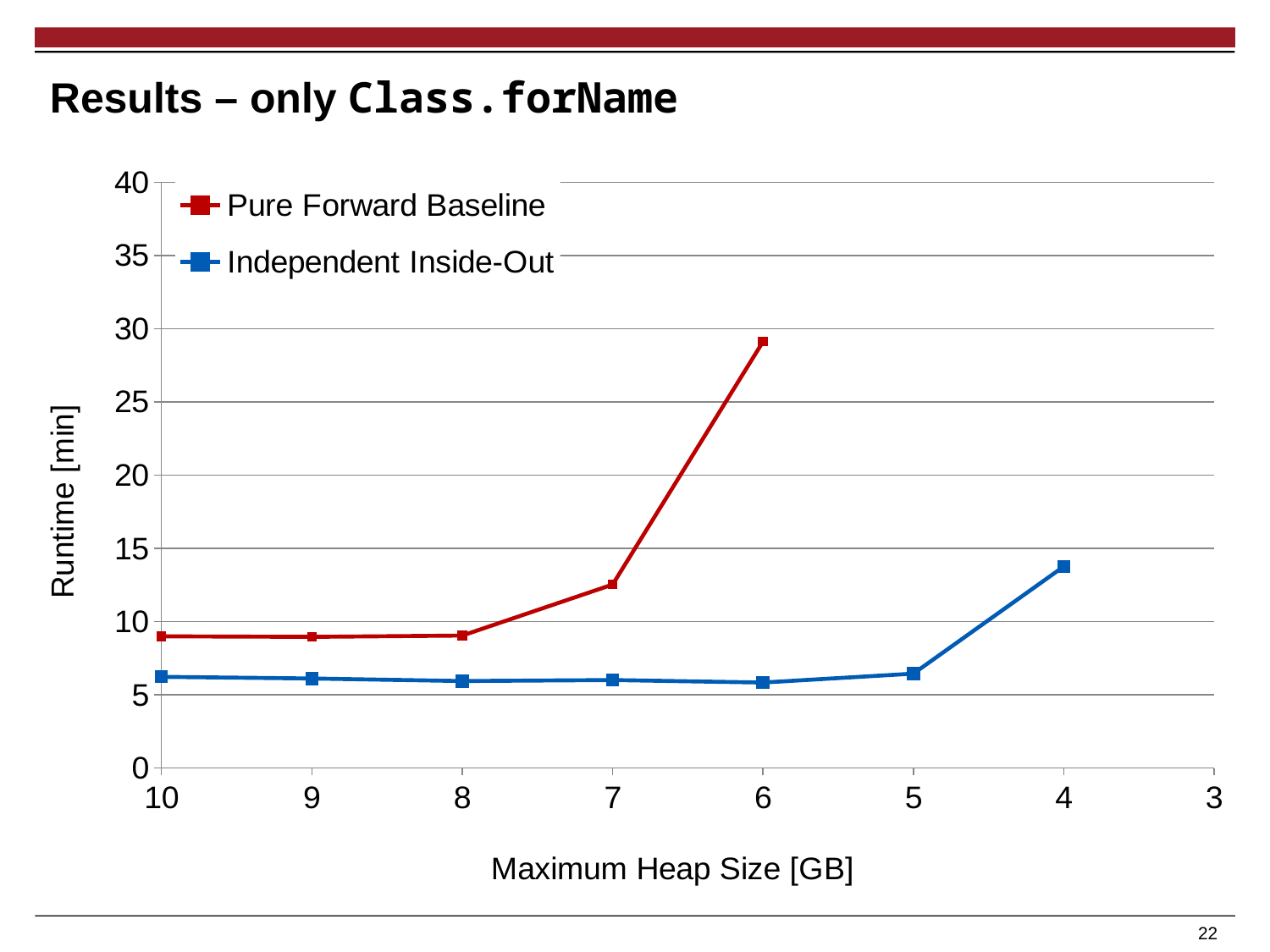
Is the runtime for Pure Forward Baseline at a maximum heap size of 7 GB greater or less than 10? greater How many series does the legend list? 2 What kind of chart is shown on the slide? line chart What is the label of the x axis? Maximum Heap Size [GB] At a maximum heap size of 7 GB, which series has the higher runtime? Pure Forward Baseline What is the label of the y axis? Runtime [min] Does the runtime for Pure Forward Baseline rise or fall as the maximum heap size decreases from 10 GB to 6 GB? rise How many data points are plotted for the Pure Forward Baseline series? 5 Is the runtime for Pure Forward Baseline at a maximum heap size of 6 GB greater or less than 25? greater Is the runtime for Independent Inside-Out at a maximum heap size of 4 GB greater or less than 10? greater How many data points are plotted for the Independent Inside-Out series? 7